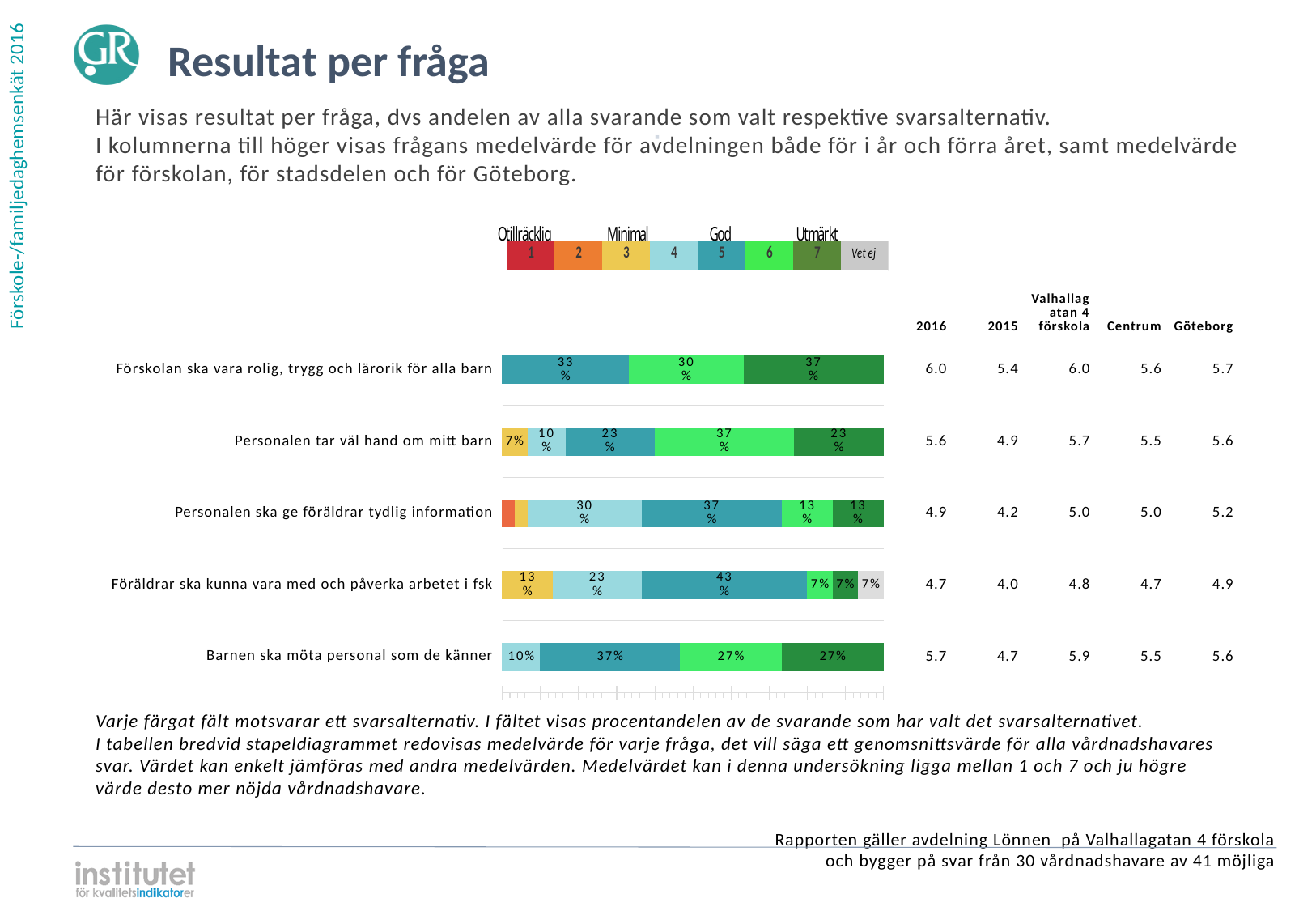
What percentage chose alternative 5 (teal) for 'Föräldrar ska kunna vara med och påverka arbetet i fsk'? 43% For 'Personalen tar väl hand om mitt barn', which is larger: the share for alternative 3 or the share for alternative 5? Alternative 5 Which colour represents answer alternative 1 in the legend? Red What percentage chose alternative 4 (light blue) for 'Barnen ska möta personal som de känner'? 10% What percentage of respondents chose alternative 7 (dark green) for 'Förskolan ska vara rolig, trygg och lärorik för alla barn'? 37% How many questions (categories) are plotted in the bar chart? 5 For 'Personalen ska ge föräldrar tydlig information', which answer alternative has the largest share? 5 What percentage chose alternative 6 (light green) for 'Personalen tar väl hand om mitt barn'? 37% What percentage chose 'Vet ej' (grey) for 'Föräldrar ska kunna vara med och påverka arbetet i fsk'? 7% How many answer alternatives does the legend above the chart list? 8 For 'Barnen ska möta personal som de känner', what is the difference between the share for alternative 5 and the share for alternative 4? 27% What kind of chart is shown on the slide? Stacked bar chart